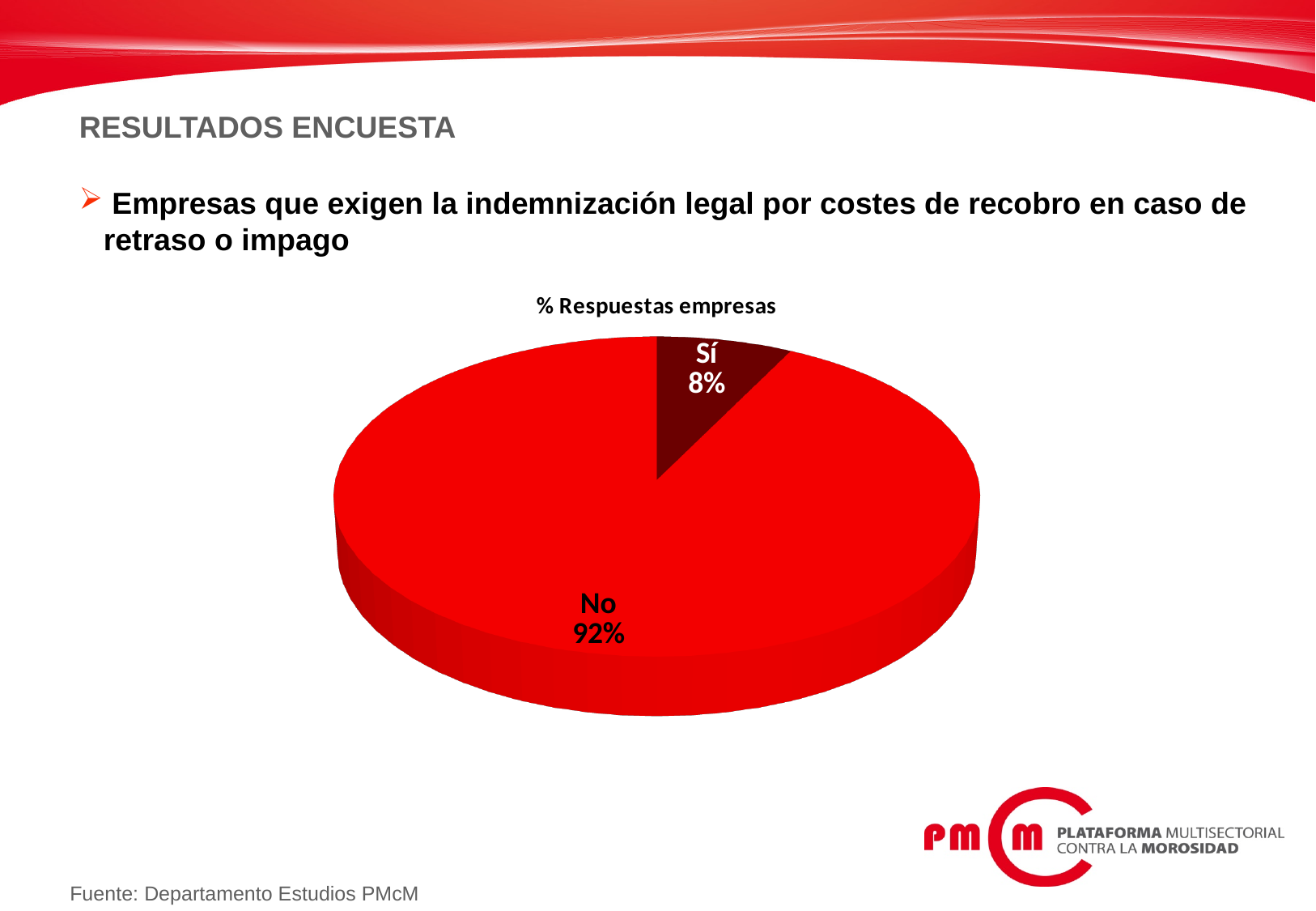
What percentage of companies answered "No"? 92% What colour is the "Sí" slice of the pie? Dark red What kind of chart is shown on the slide? Pie chart How many slices does the pie chart have? 2 Which response has the smallest share of the pie? Sí What is the difference in percentage points between the "No" and "Sí" responses? 84 What share of the pie does the "Sí" slice represent? 8% Which is larger, the share for "Sí" or the share for "No"? No What percentage of companies answered "Sí"? 8% Which response has the largest share of the pie? No What is the title of the chart? % Respuestas empresas